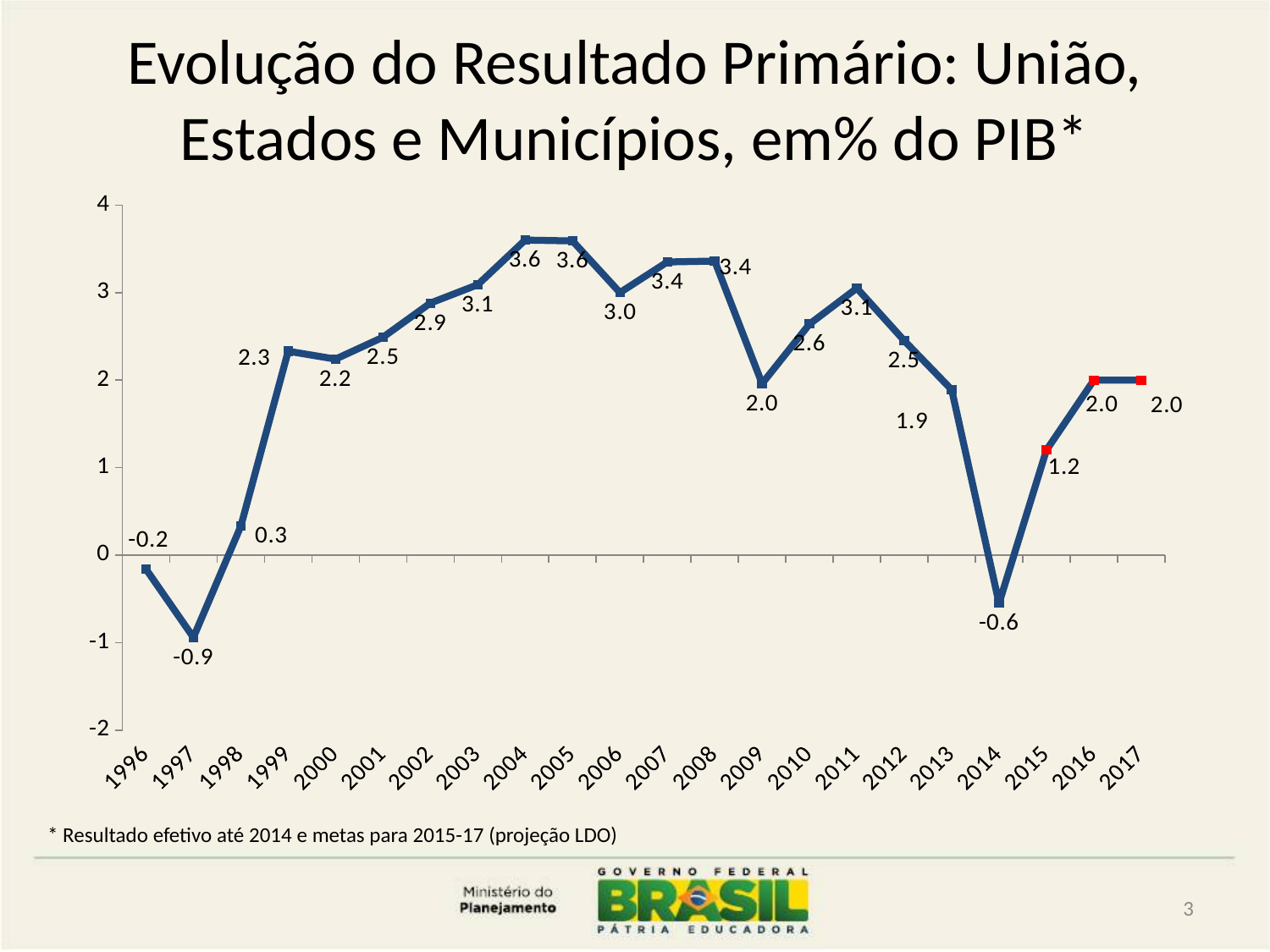
What kind of chart is shown on the slide? Line chart What is the highest value shown on the chart? 3.6 How many years are plotted on the chart? 22 What is the value for 2014? -0.6 Which is larger, the value for 2011 or the value for 2012? 2011 Is the value for 2004 greater or less than 3? greater What is the difference between the values for 2008 and 2009? 1.4 What is the difference between the values for 2013 and 2014? 2.5 Do the values rise or fall from 2011 to 2014? Fall What is the value for 1999? 2.3 Which year has the lowest value? 1997 What is the value for 2015? 1.2